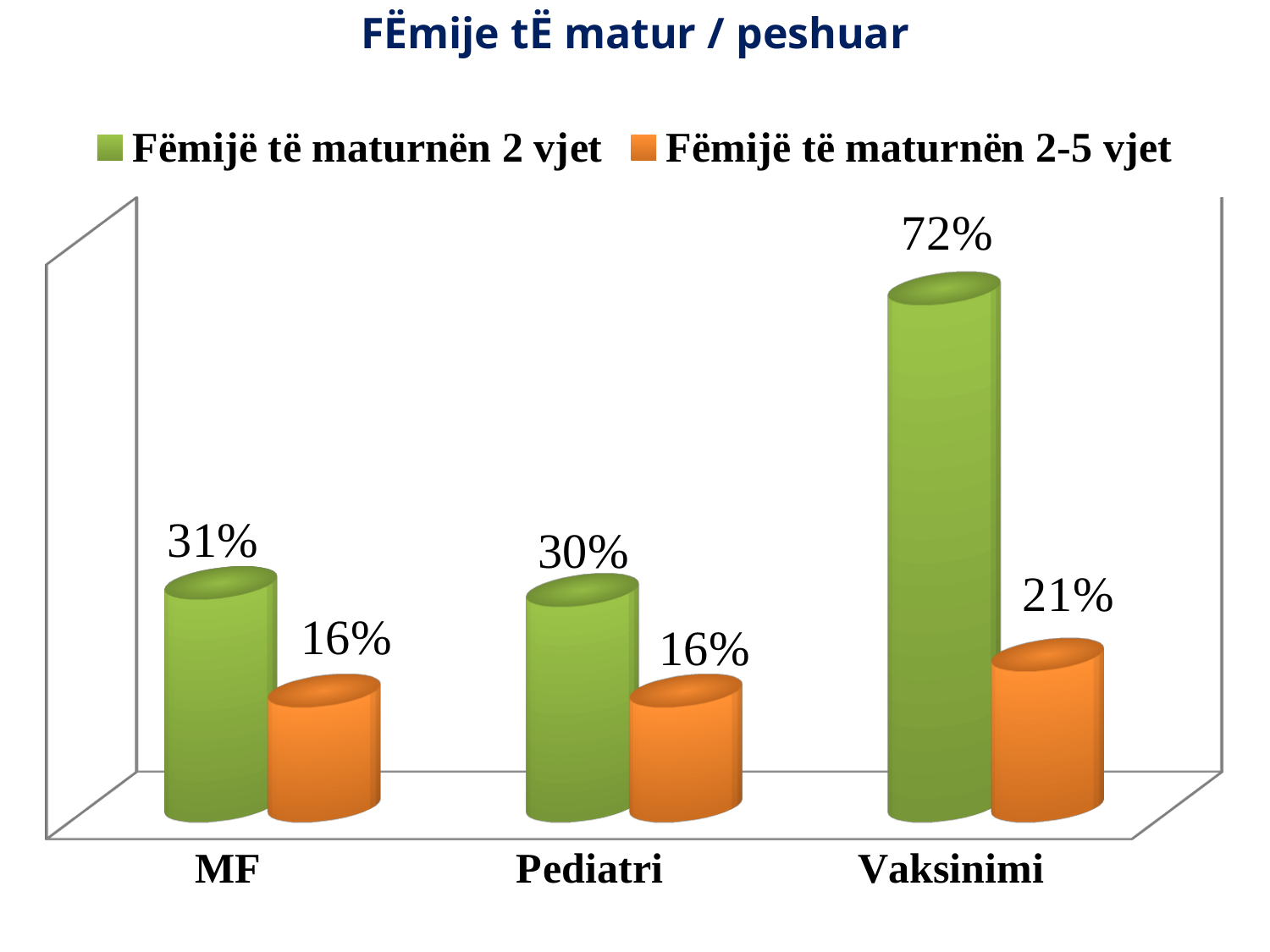
Which category has the highest value in the 'Fëmijë të maturnën 2 vjet' series? Vaksinimi How many categories are shown on the x axis? 3 What colour represents the 'Fëmijë të maturnën 2-5 vjet' series? Orange What is the difference between the 'Fëmijë të maturnën 2 vjet' and 'Fëmijë të maturnën 2-5 vjet' values for Vaksinimi? 51% How many series does the legend list? 2 Which is larger for Pediatri: the 'Fëmijë të maturnën 2 vjet' value or the 'Fëmijë të maturnën 2-5 vjet' value? Fëmijë të maturnën 2 vjet Which category has the highest value in the 'Fëmijë të maturnën 2-5 vjet' series? Vaksinimi What is the value for MF in the 'Fëmijë të maturnën 2 vjet' series? 31% What kind of chart is shown on the slide? Bar chart What is the difference between the 'Fëmijë të maturnën 2 vjet' values for Vaksinimi and MF? 41% What is the value for Vaksinimi in the 'Fëmijë të maturnën 2-5 vjet' series? 21% What is the value for Pediatri in the 'Fëmijë të maturnën 2 vjet' series? 30%